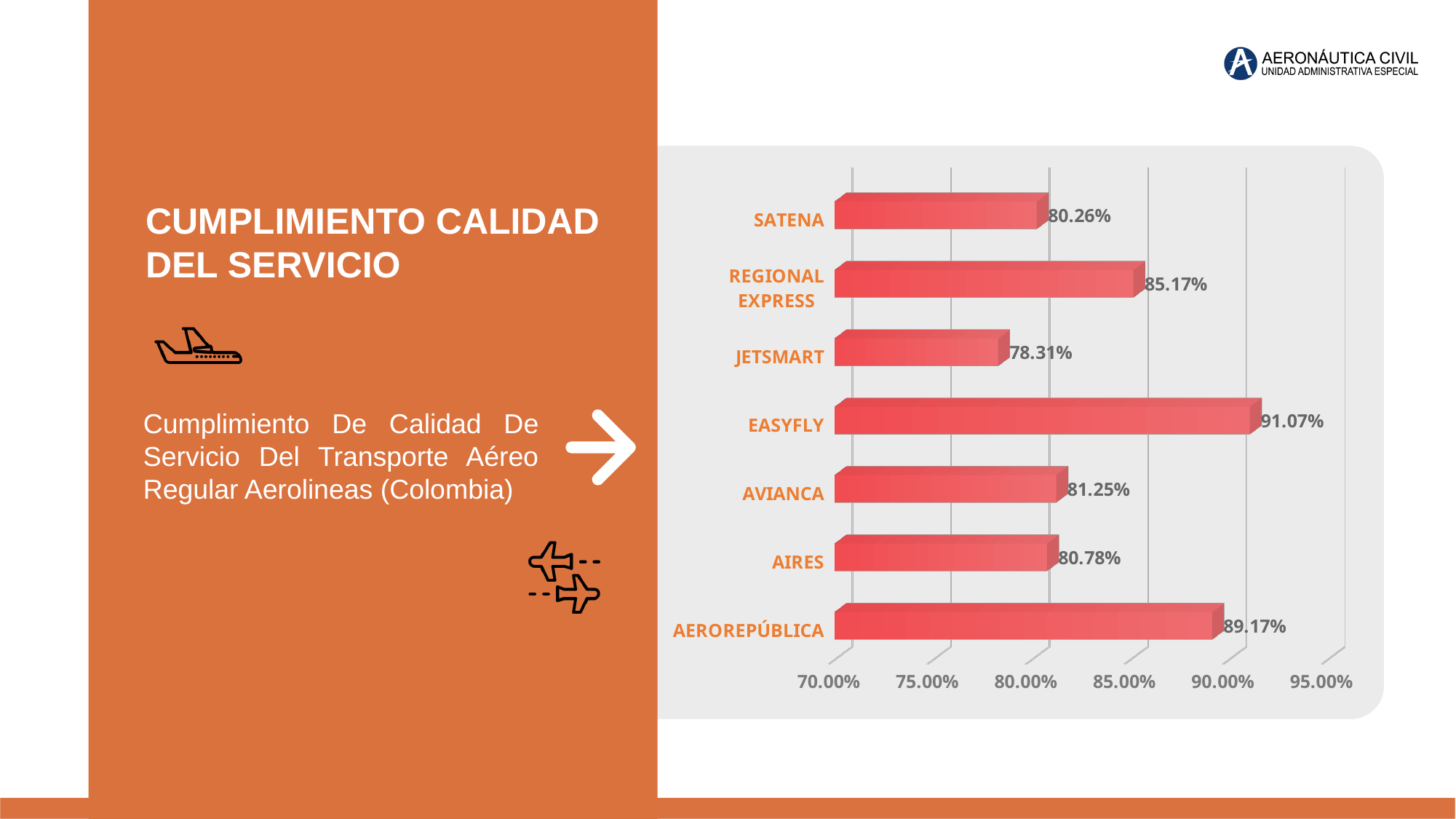
Which is larger, the value for REGIONAL EXPRESS or the value for AEROREPÚBLICA? AEROREPÚBLICA What is the difference between the values for AVIANCA and AIRES? 0.47% What is the value for REGIONAL EXPRESS? 85.17% What is the value for SATENA? 80.26% What is the value for EASYFLY? 91.07% What kind of chart is shown on the slide? bar chart Which airline has the highest value? EASYFLY Is the value for JETSMART greater or less than 80.00%? less What is the value for AEROREPÚBLICA? 89.17% How many airlines are shown in the chart? 7 Which airline has the lowest value? JETSMART What is the difference between the values for EASYFLY and JETSMART? 12.76%